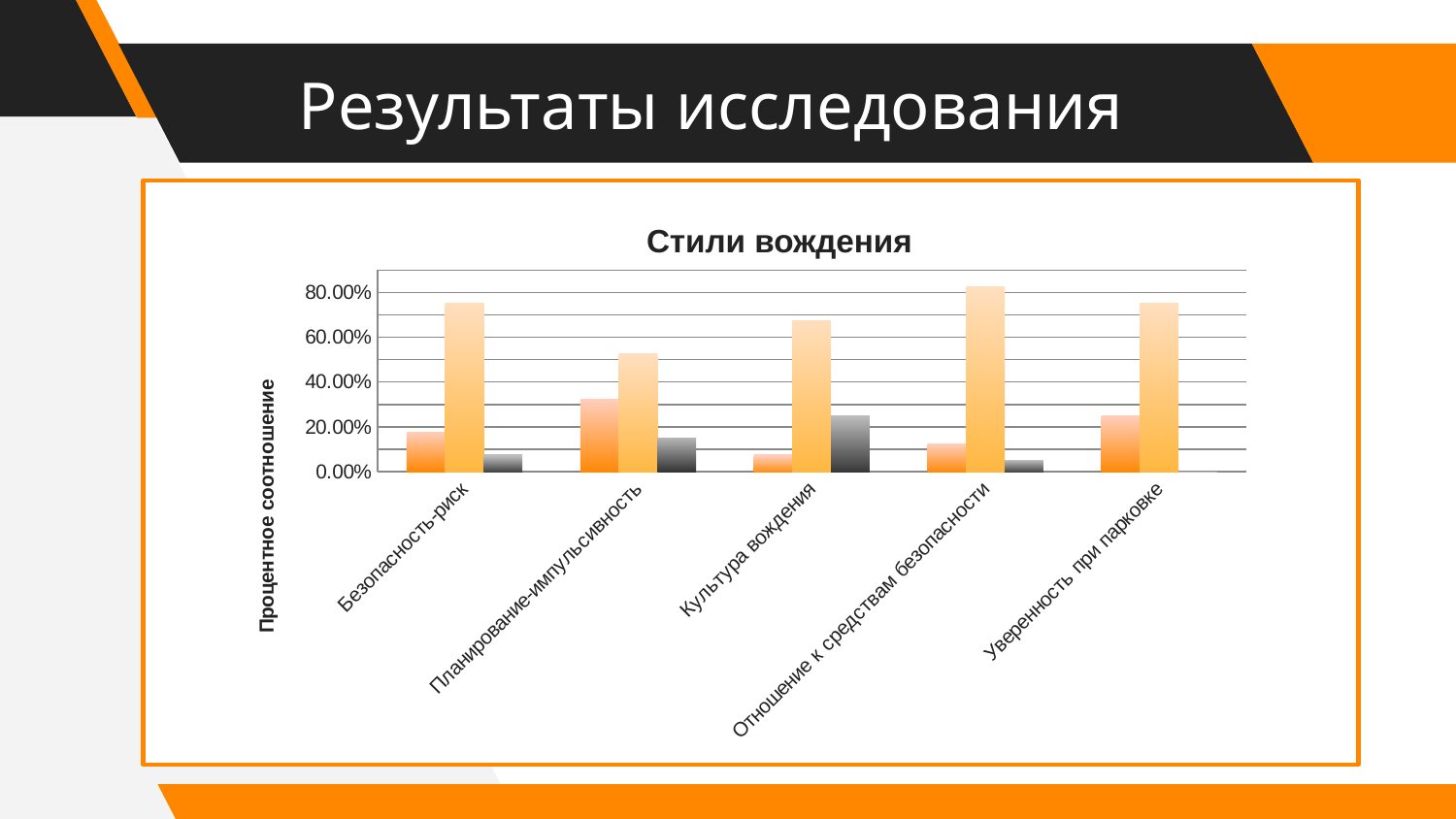
Is the light orange bar for Безопасность-риск greater or less than 60.00%? greater What type of chart is shown on the slide? bar chart How many categories are shown on the x axis? 5 Which category has the tallest dark orange (first) bar? Планирование-импульсивность Is the light orange bar for Планирование-импульсивность greater or less than 60.00%? less Which is larger: the dark orange (first) bar for Безопасность-риск or for Культура вождения? Безопасность-риск What is the label of the vertical axis? Процентное соотношение Which category has the tallest light orange bar? Отношение к средствам безопасности Is the dark orange (first) bar for Планирование-импульсивность greater or less than 40.00%? less Which category has the shortest light orange bar? Планирование-импульсивность Which category has the tallest dark gray bar? Культура вождения What is the title of the chart? Стили вождения